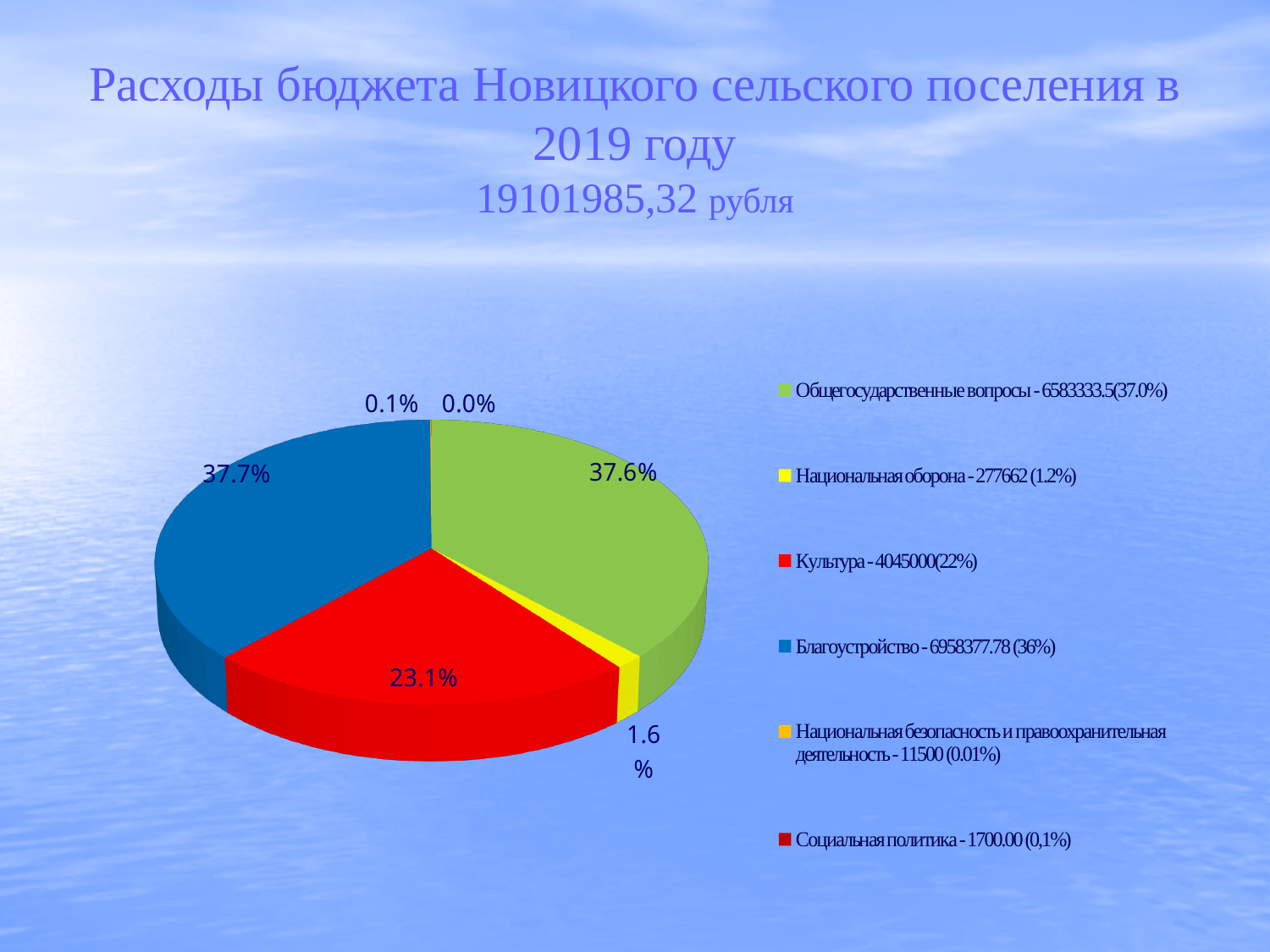
According to the legend, what amount is given for Культура? 4045000 What percentage label is shown on the Благоустройство slice of the pie chart? 37.7% Which slice is larger in the pie chart: Культура or Национальная оборона? Культура How many categories does the legend of the pie chart list? 6 Which category has the smallest share of the pie chart? Социальная политика What percentage label is shown on the Национальная оборона slice of the pie chart? 1.6% What percentage label is shown on the Общегосударственные вопросы slice of the pie chart? 37.6% What percentage label is shown on the Культура slice of the pie chart? 23.1% What is the difference in percentage points between the Культура slice (23.1%) and the Национальная оборона slice (1.6%)? 21.5 What kind of chart is shown on the slide? pie chart What total amount in rubles is stated in the slide title? 19101985,32 рубля Is the share of the Культура slice greater or less than 20%? greater